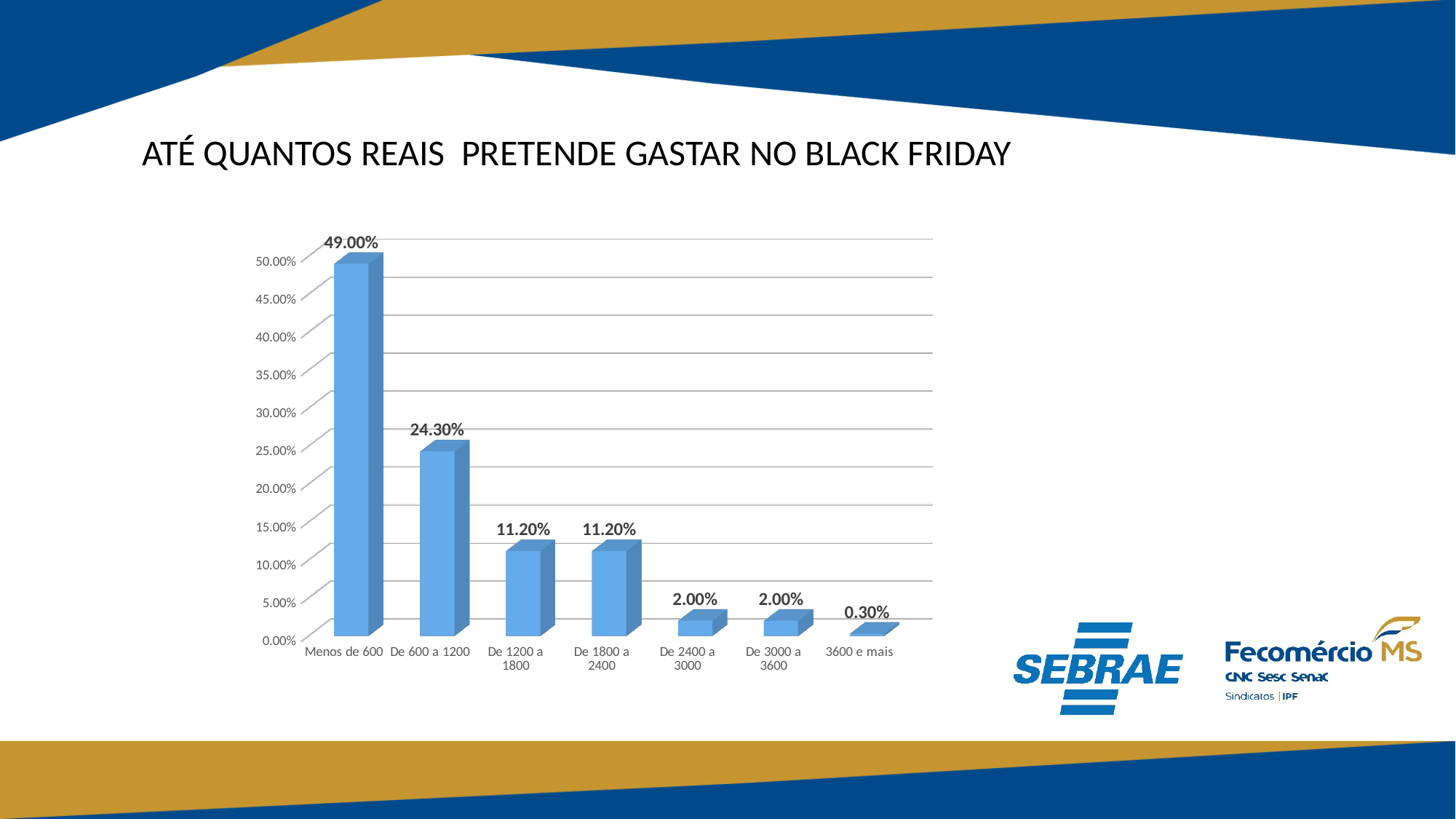
What is the value for "3600 e mais"? 0.30% What kind of chart is shown on the slide? Bar chart Which category has the highest value? Menos de 600 How many categories are shown on the x axis? 7 What is the title of the slide above the chart? ATÉ QUANTOS REAIS PRETENDE GASTAR NO BLACK FRIDAY Which category has the lowest value? 3600 e mais What is the value for "Menos de 600"? 49.00% What is the difference between the values for "Menos de 600" and "De 600 a 1200"? 24.70% What is the value for "De 600 a 1200"? 24.30% What is the value for "De 1800 a 2400"? 11.20% Is the value for "De 600 a 1200" greater or less than 20.00%? greater Which is larger, the value for "De 600 a 1200" or the value for "De 1200 a 1800"? De 600 a 1200